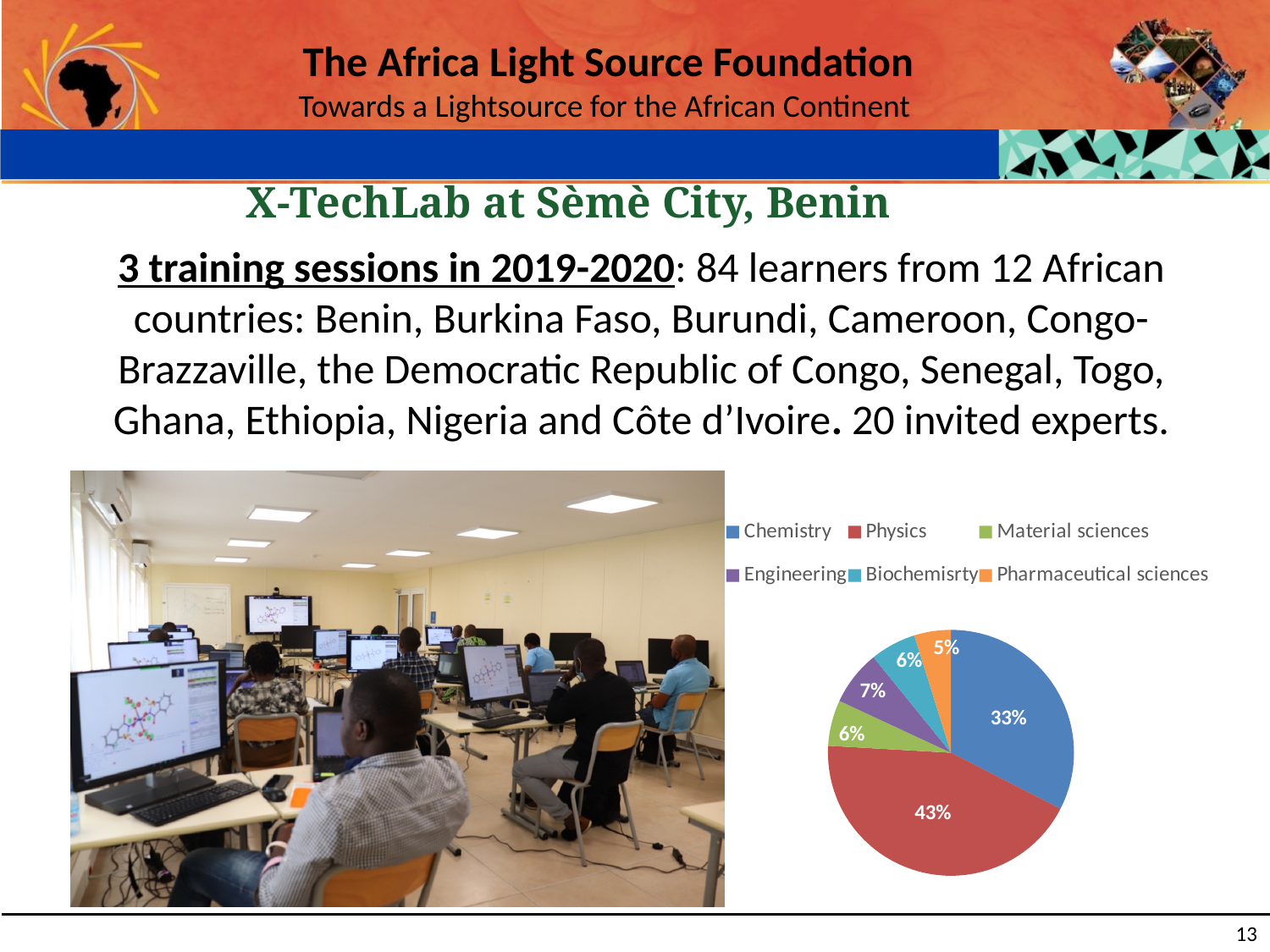
Which field has the largest slice of the pie? Physics What kind of chart is shown on the slide? pie chart What colour is the Physics slice in the pie chart? red What percentage is shown for Material sciences? 6% What percentage is shown for Engineering? 7% How many slices does the pie chart have? 6 What percentage is shown for Pharmaceutical sciences? 5% Which field has the smallest slice of the pie? Pharmaceutical sciences What share of the pie does Physics account for? 43% By how many percentage points does Physics exceed Chemistry? 10 Which is larger, the share for Engineering or the share for Biochemisrty? Engineering What share of the pie does Chemistry account for? 33%